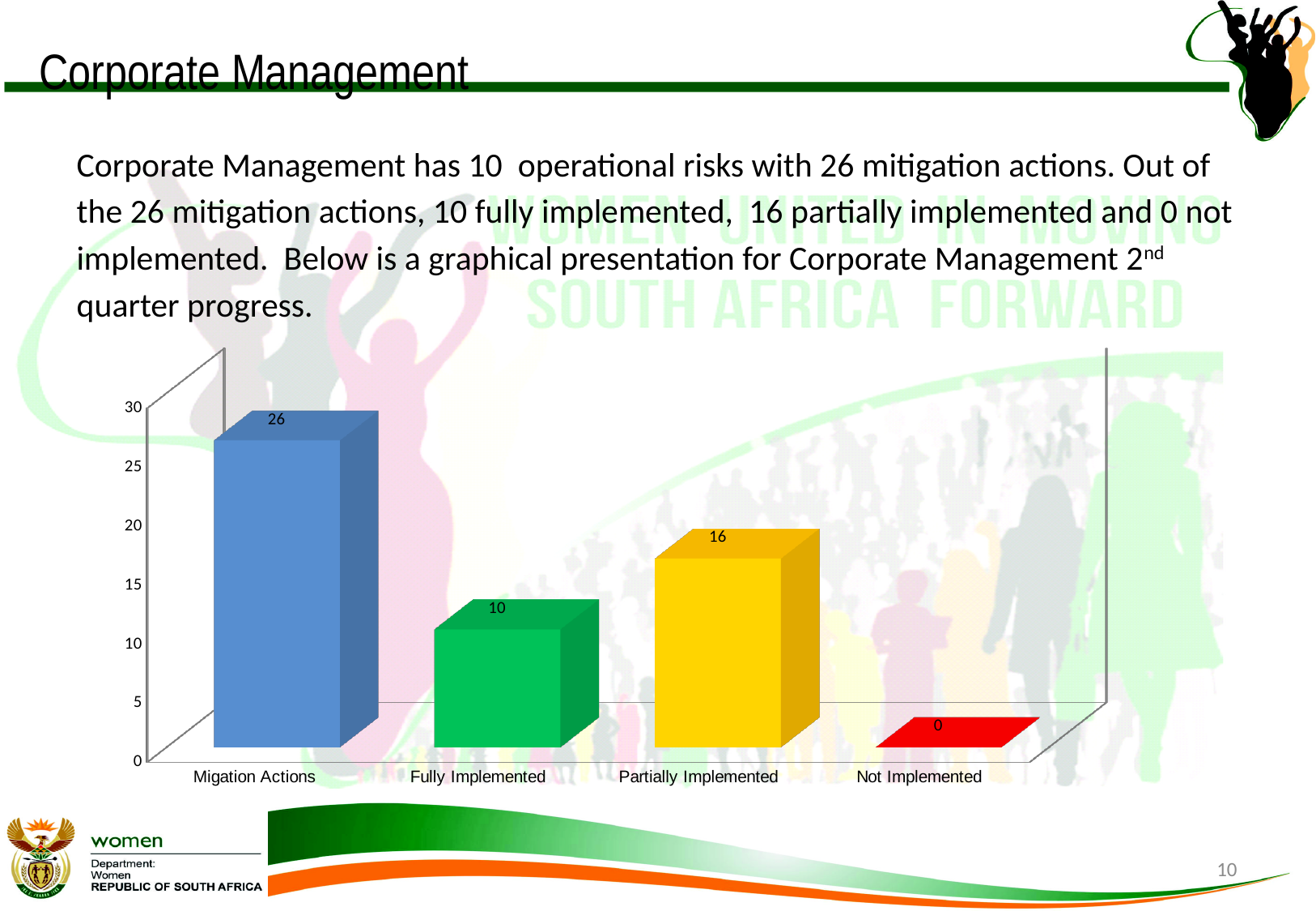
Is the value for Migation Actions greater or less than 25? greater Which is larger, Fully Implemented or Partially Implemented? Partially Implemented What is the value for Migation Actions? 26 What is the value for Partially Implemented? 16 What colour is the bar for Not Implemented? red What kind of chart is shown on the slide? bar chart Which category has the highest value? Migation Actions How many categories are shown on the x axis? 4 What is the value for Fully Implemented? 10 Which category has the lowest value? Not Implemented What is the difference between Partially Implemented and Fully Implemented? 6 What is the value for Not Implemented? 0